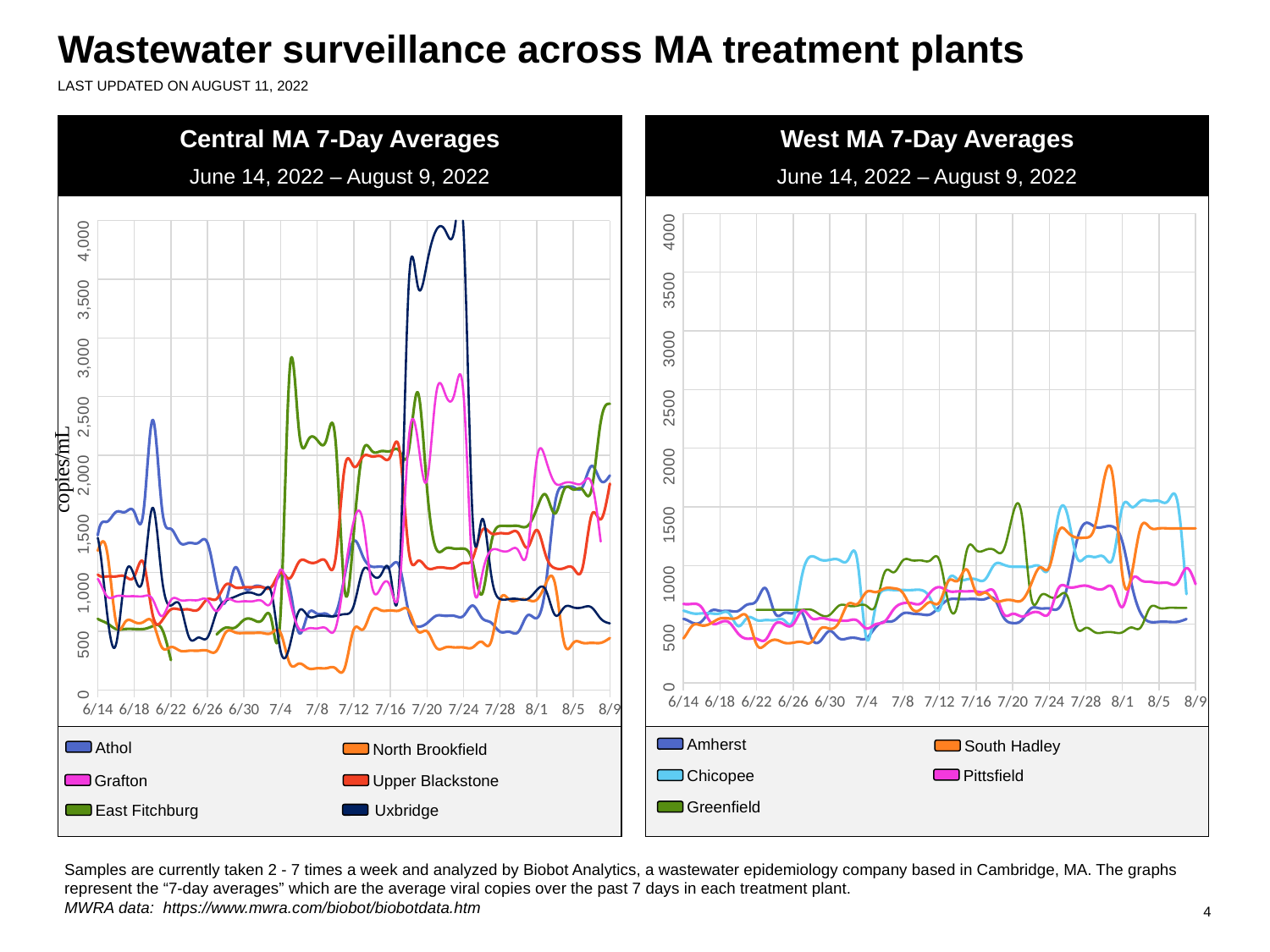
What is the y-axis label on the Central MA 7-Day Averages chart? copies/mL How many series does the legend of the Central MA 7-Day Averages chart list? 6 In the West MA 7-Day Averages chart, is the value for Greenfield on 8/9 greater or less than 1,000? less In the Central MA 7-Day Averages chart, is the peak value for Grafton greater or less than 2,500? greater In the West MA 7-Day Averages chart, is the peak value for South Hadley greater or less than 1,500? greater How many series does the legend of the West MA 7-Day Averages chart list? 5 In the West MA 7-Day Averages chart, which series reaches the highest value? South Hadley In the Central MA 7-Day Averages chart, which series reaches the highest value? Uxbridge What kind of chart is the Central MA 7-Day Averages chart? Line chart What date range is shown in the subtitle of the West MA 7-Day Averages chart? June 14, 2022 – August 9, 2022